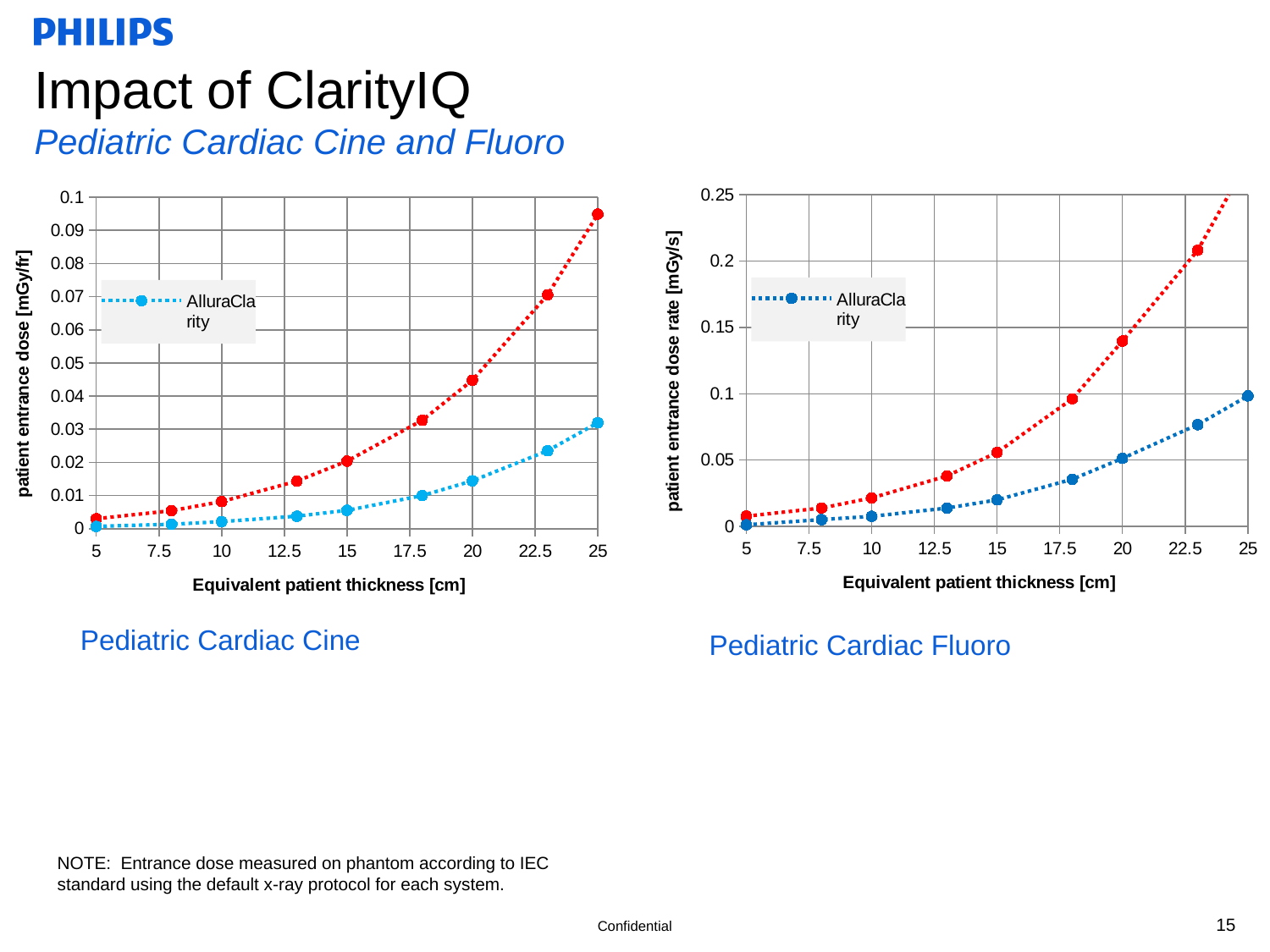
In the Pediatric Cardiac Fluoro chart, is the AlluraClarity value at 25 cm greater or less than 0.05? greater How many tick labels are shown on the x axis of the Pediatric Cardiac Cine chart? 9 In the Pediatric Cardiac Cine chart, does the AlluraClarity series rise or fall as equivalent patient thickness increases? rise In the Pediatric Cardiac Fluoro chart, at 20 cm, which series has the larger value, the red series or AlluraClarity? the red series What kind of chart is the Pediatric Cardiac Cine chart on the left? line chart What is the y-axis title of the Pediatric Cardiac Fluoro chart? patient entrance dose rate [mGy/s] What is the highest tick value on the y axis of the Pediatric Cardiac Cine chart? 0.1 In the Pediatric Cardiac Fluoro chart, is the red series value at 20 cm greater or less than 0.15? less In the Pediatric Cardiac Cine chart, is the AlluraClarity value at 25 cm greater or less than 0.02? greater In the Pediatric Cardiac Cine chart, at 25 cm, which series has the larger value, the red series or AlluraClarity? the red series In the Pediatric Cardiac Fluoro chart, does the red series rise or fall as equivalent patient thickness increases? rise